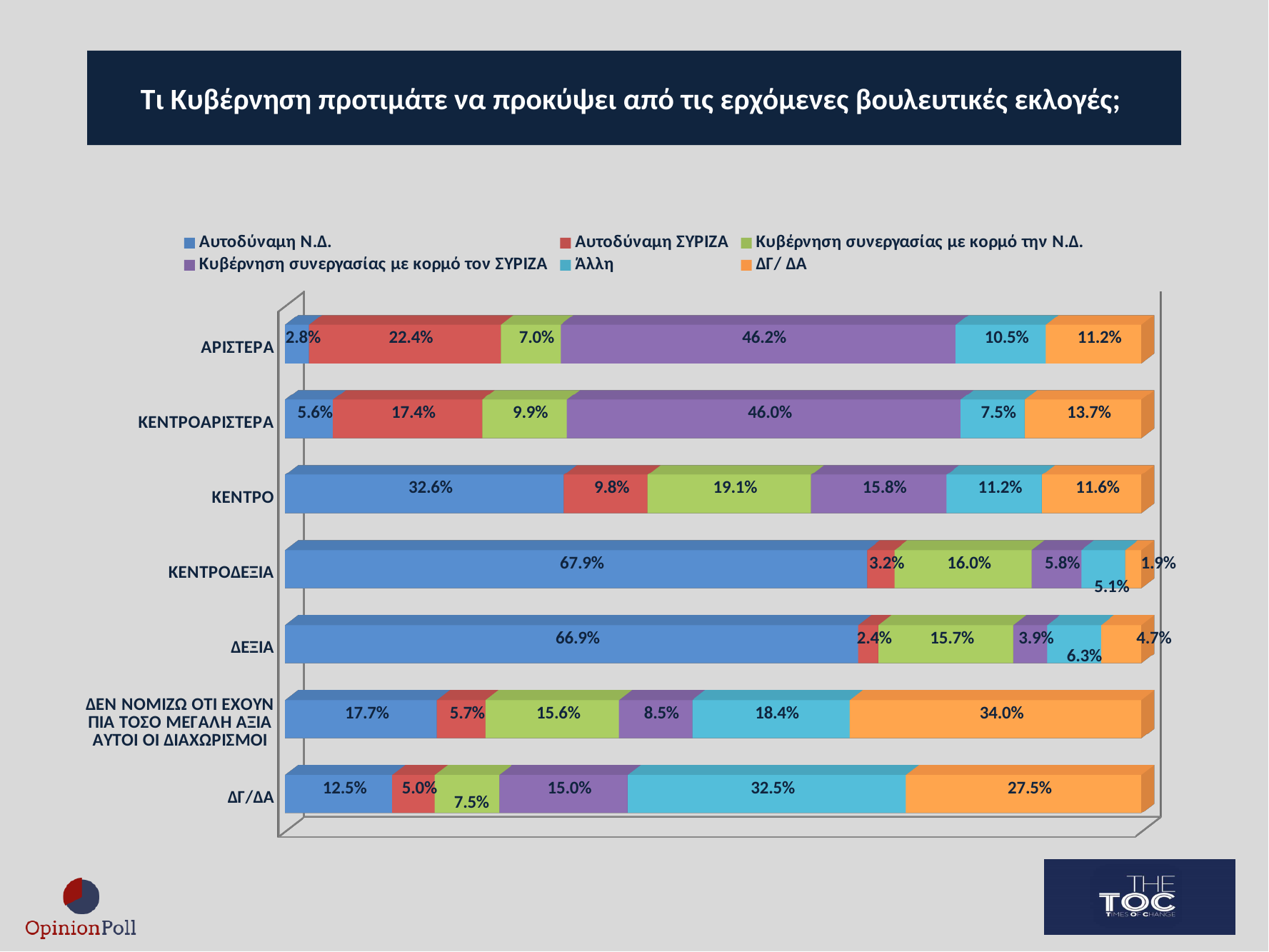
Which category has the highest value for Αυτοδύναμη Ν.Δ.? ΚΕΝΤΡΟΔΕΞΙΑ How many categories are shown on the chart? 7 Which colour represents Άλλη in the legend? Light blue How many series does the legend list? 6 What is the value for Αυτοδύναμη Ν.Δ. in the ΚΕΝΤΡΟ category? 32.6% What is the value for Άλλη in the ΔΓ/ΔΑ category? 32.5% What percentage of ΑΡΙΣΤΕΡΑ respondents prefer Κυβέρνηση συνεργασίας με κορμό τον ΣΥΡΙΖΑ? 46.2% What is the ΔΓ/ ΔΑ value for the category ΔΕΝ ΝΟΜΙΖΩ ΟΤΙ ΕΧΟΥΝ ΠΙΑ ΤΟΣΟ ΜΕΓΑΛΗ ΑΞΙΑ ΑΥΤΟΙ ΟΙ ΔΙΑΧΩΡΙΣΜΟΙ? 34.0% What is the difference between the Αυτοδύναμη ΣΥΡΙΖΑ values for ΑΡΙΣΤΕΡΑ and ΚΕΝΤΡΟΑΡΙΣΤΕΡΑ? 5.0 percentage points What kind of chart is shown on the slide? Stacked bar chart Which category has the lowest value for Αυτοδύναμη Ν.Δ.? ΑΡΙΣΤΕΡΑ Which is larger: the Κυβέρνηση συνεργασίας με κορμό την Ν.Δ. value for ΚΕΝΤΡΟ or for ΚΕΝΤΡΟΔΕΞΙΑ? ΚΕΝΤΡΟ